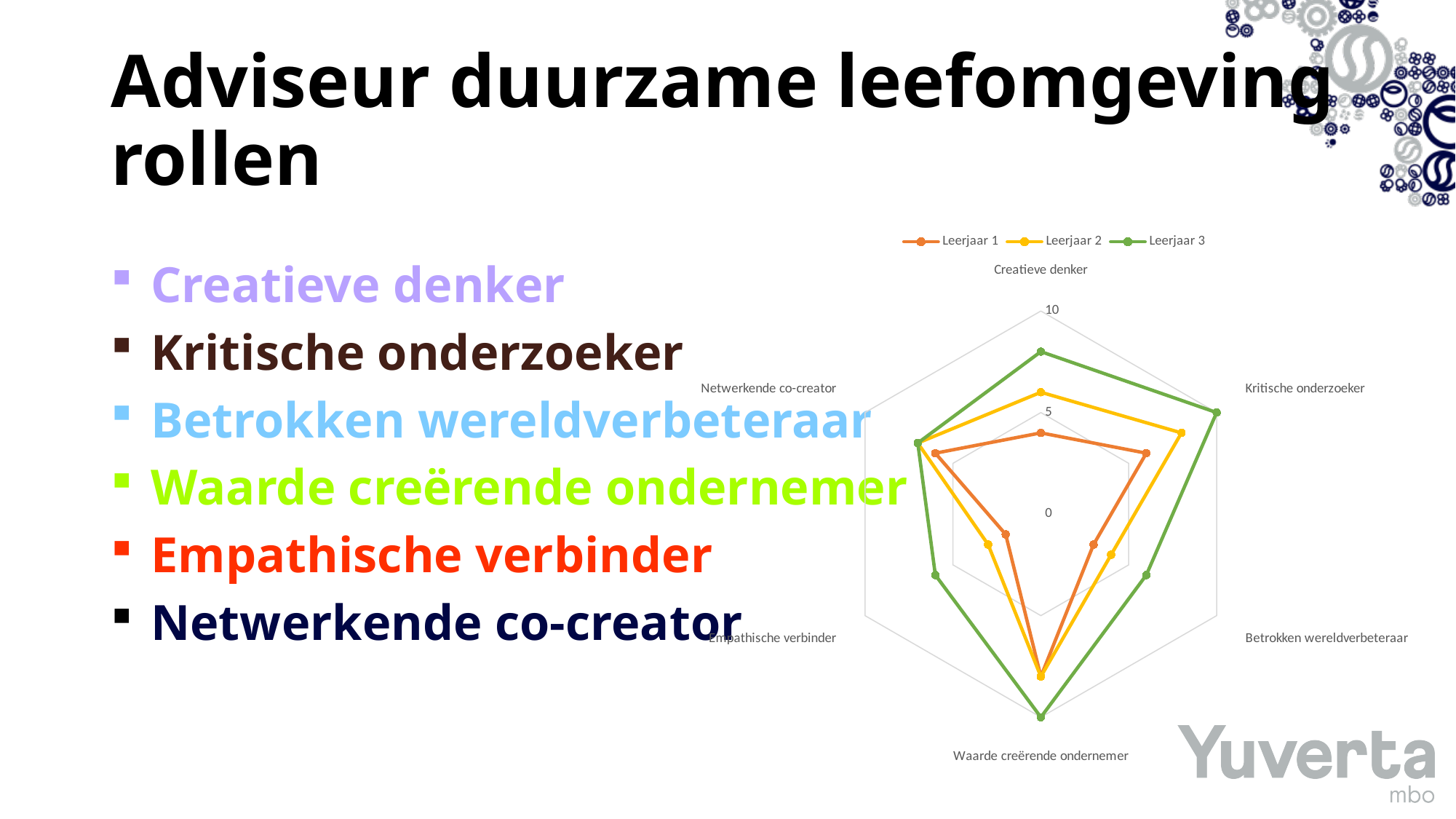
Is the value of Leerjaar 3 for Creatieve denker greater or less than 5? greater Which series are listed in the chart legend? Leerjaar 1, Leerjaar 2, Leerjaar 3 Which series has the higher value for Creatieve denker, Leerjaar 1 or Leerjaar 3? Leerjaar 3 What is the highest value shown on the chart's axis scale? 10 Is the value of Leerjaar 2 for Waarde creërende ondernemer greater or less than 5? greater For the Leerjaar 1 series, which category has the highest value? Waarde creërende ondernemer How many categories (axes) does the radar chart have? 6 What kind of chart is shown on the slide? Radar chart Is the value of Leerjaar 1 for Betrokken wereldverbeteraar greater or less than 5? less Which series has the higher value for Betrokken wereldverbeteraar, Leerjaar 2 or Leerjaar 3? Leerjaar 3 How many series does the chart legend list? 3